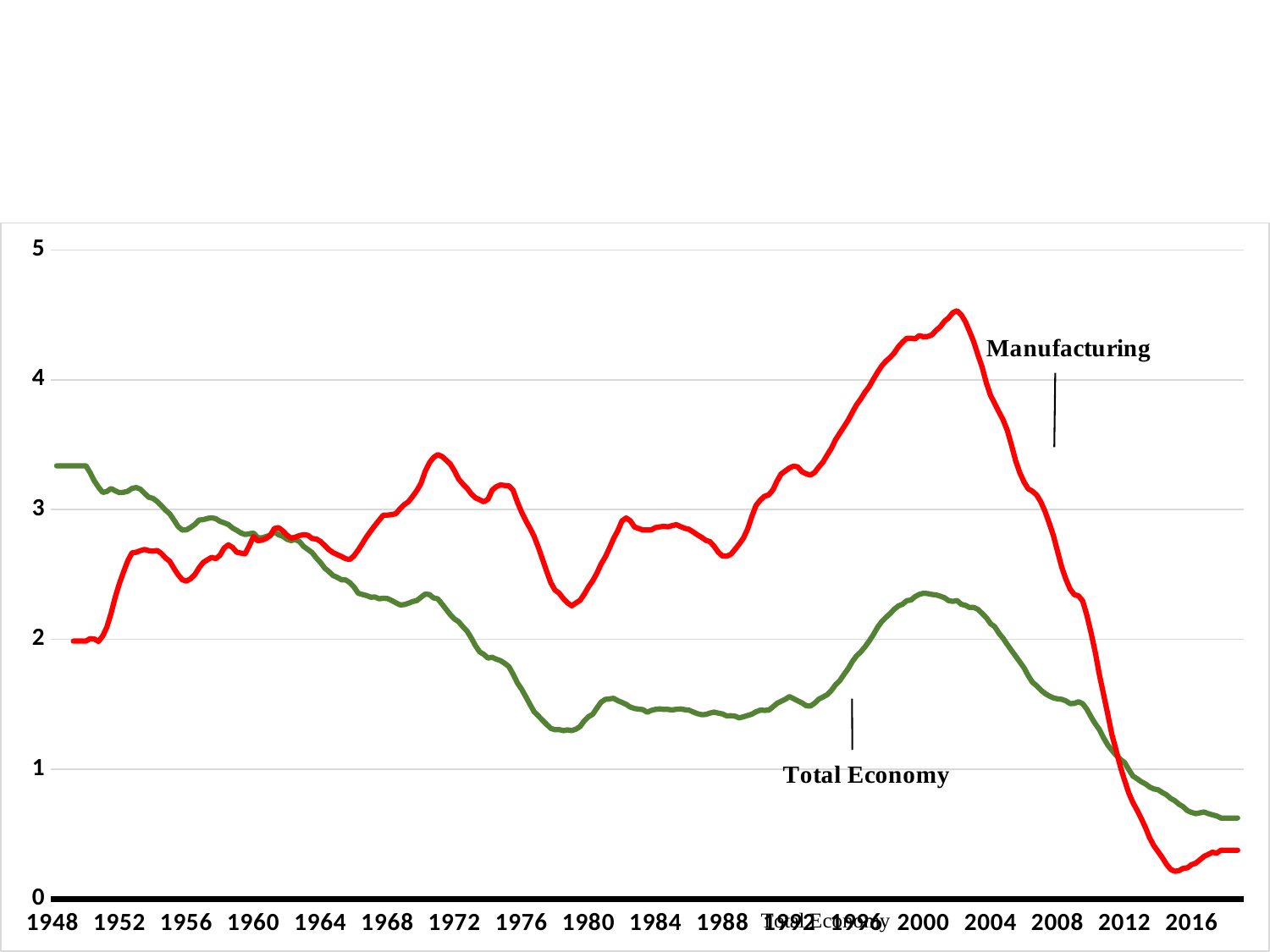
Which series is drawn in green? Total Economy Is the value for Total Economy in 1948 greater or less than 3? greater Is the value for Manufacturing around 2002 greater or less than 4? greater In 2000, which series has the higher value, Manufacturing or Total Economy? Manufacturing Is the value for Manufacturing in 2016 greater or less than 1? less In 1948, which series has the higher value, Manufacturing or Total Economy? Total Economy What kind of chart is shown on the slide? line chart Which series is drawn in red? Manufacturing Does the Manufacturing series rise or fall between 2004 and 2016? fall Which series reaches the highest value anywhere on the chart? Manufacturing How many series are plotted on the chart? 2